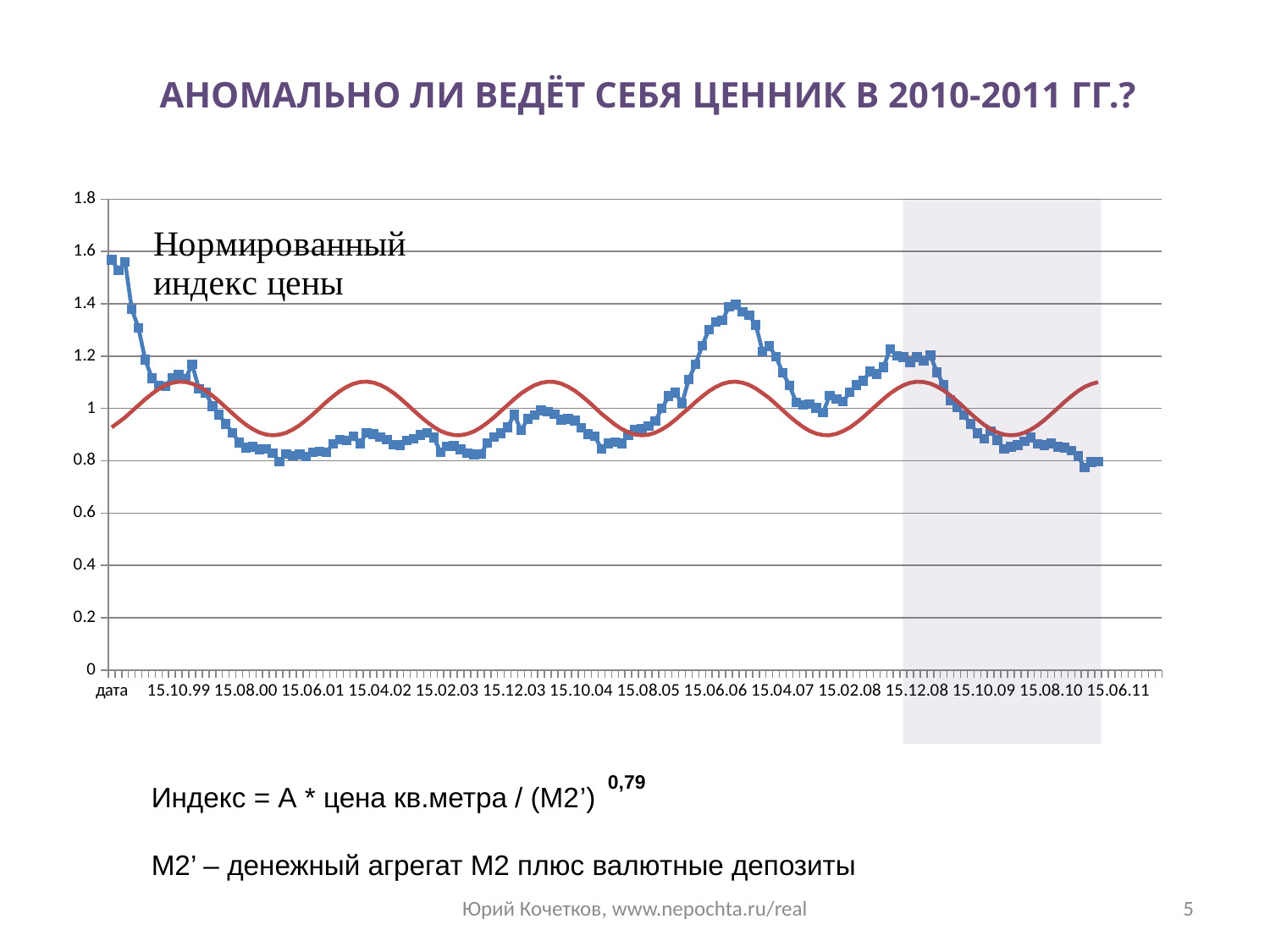
Is the value of the blue line at 15.08.00 greater or less than 1? less Is the value of the blue line at 15.10.09 greater or less than 1? less Is the value of the blue line at 15.06.06 greater or less than 1.2? greater Does the blue line rise or fall between 15.08.05 and 15.06.06? rise Is the blue line higher at its first point (дата) or at 15.06.06? first point (дата) What is the title of the slide above the chart? АНОМАЛЬНО ЛИ ВЕДЁТ СЕБЯ ЦЕННИК В 2010-2011 ГГ.? What label is written inside the chart area near the top left? Нормированный индекс цены What is the highest tick value shown on the vertical axis? 1.8 What kind of chart is shown on the slide? line chart